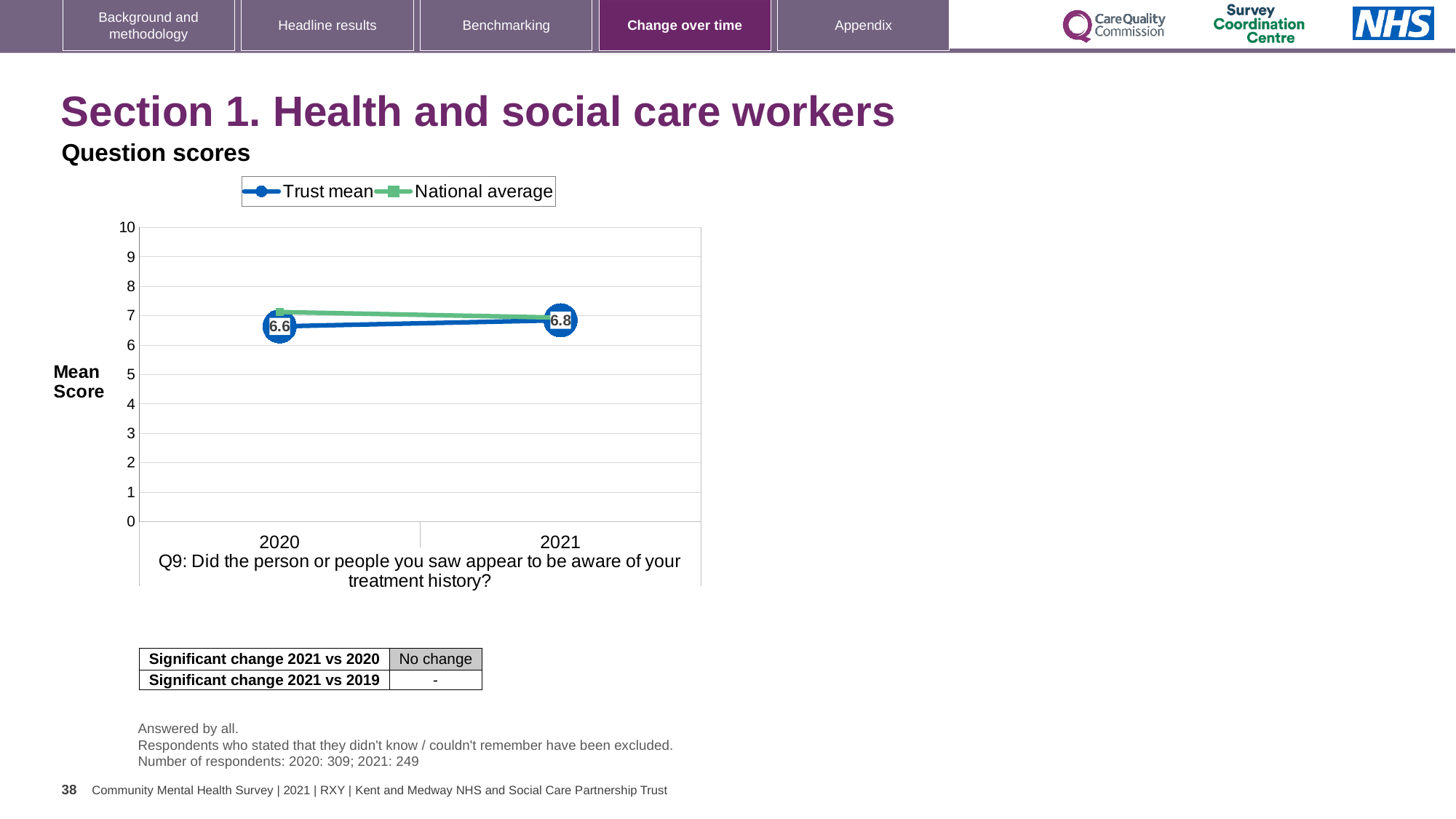
Does the Trust mean rise or fall from 2020 to 2021? rise Is the National average value for 2020 greater or less than 6? greater What is the label on the y axis of the chart? Mean Score How many years are plotted on the x axis? 2 What kind of chart is shown on the slide? line chart How many series does the legend list? 2 What is the Trust mean score for 2020? 6.6 Is the National average value for 2021 greater or less than 8? less By how much did the Trust mean change from 2020 to 2021? 0.2 What is the Trust mean score for 2021? 6.8 Which year has the higher Trust mean, 2020 or 2021? 2021 In 2020, which is higher: the Trust mean or the National average? National average